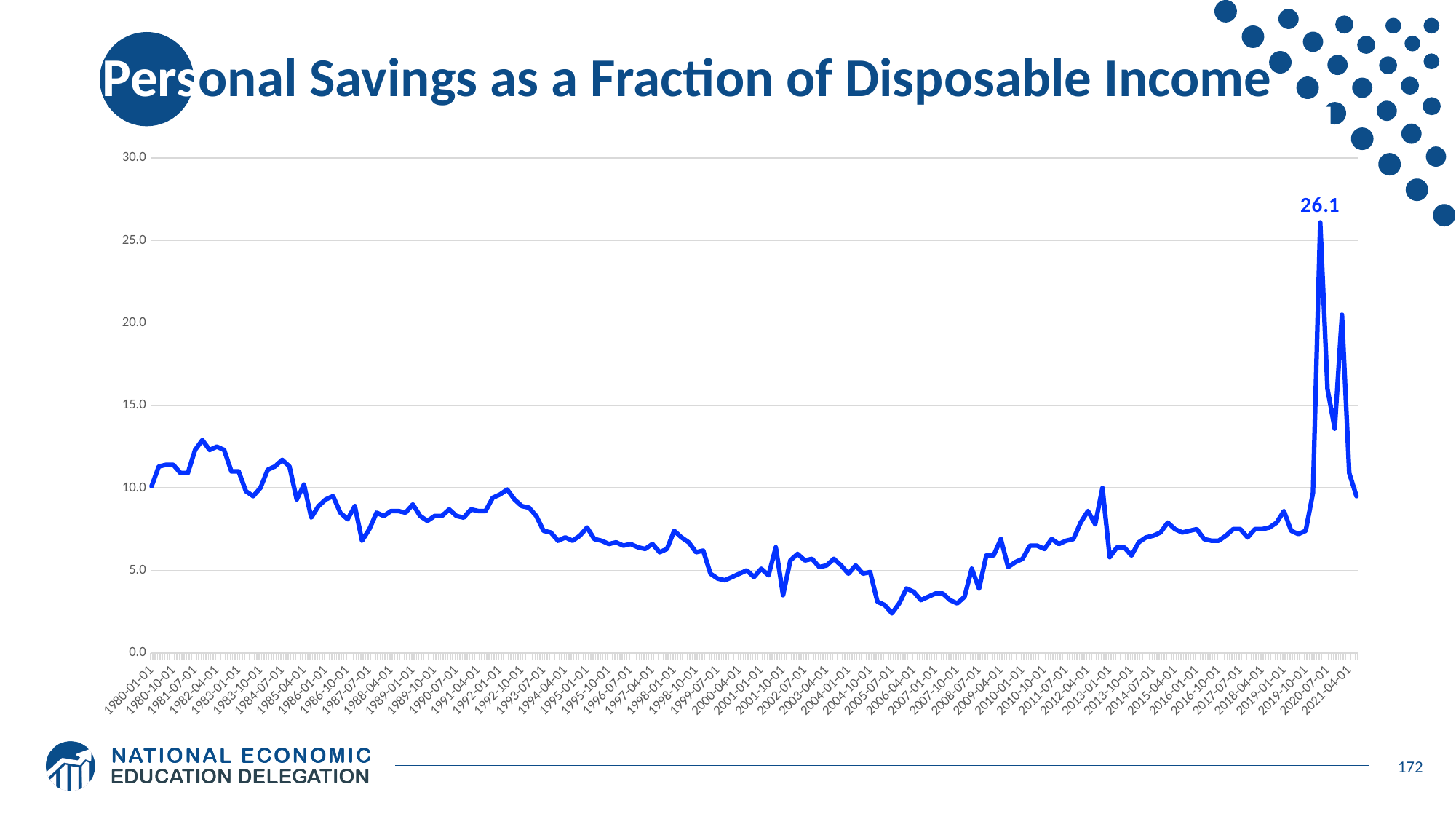
Around which year does the line reach its peak value of 26.1? 2020 How many lines are plotted on the chart? 1 Is the value around 1982-04-01 greater or less than 10.0? greater What is the title of the chart? Personal Savings as a Fraction of Disposable Income Is the value around 2005-07-01 greater or less than 5.0? less Do the values generally rise or fall between 1980 and 2005? fall Is the value around 2016-01-01 greater or less than 5.0? greater What kind of chart is shown on the slide? line chart What is the highest value labelled on the chart? 26.1 Which is higher, the value around 1982-04-01 or the value around 2005-07-01? 1982-04-01 Do the values generally rise or fall between 2005 and 2019? rise